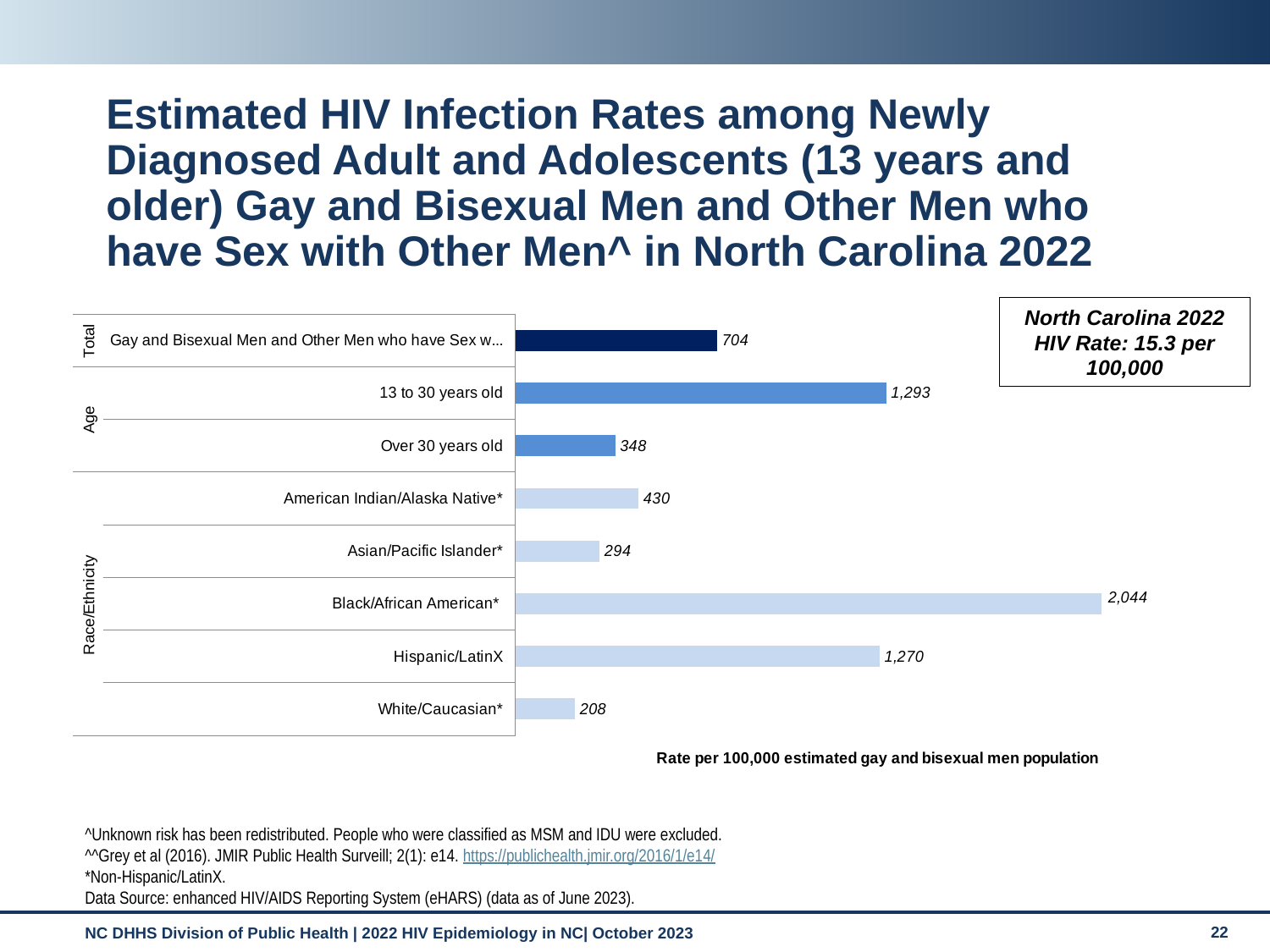
Which category on the chart has the lowest estimated HIV infection rate? White/Caucasian* What is the difference between the rates for 13 to 30 years old and Over 30 years old? 945 What is the estimated HIV infection rate for White/Caucasian* gay and bisexual men? 208 What kind of chart is shown on the slide? Bar chart Which has a higher rate, American Indian/Alaska Native* or Asian/Pacific Islander*? American Indian/Alaska Native* What is the difference between the rates for Black/African American* and Hispanic/LatinX? 774 What is the estimated HIV infection rate for the 13 to 30 years old group? 1,293 What is the estimated HIV infection rate for Black/African American* gay and bisexual men? 2,044 Which race/ethnicity category has the highest estimated HIV infection rate? Black/African American* What is the North Carolina 2022 HIV rate shown in the box on the slide? 15.3 per 100,000 How many categories are plotted on the chart? 8 What is the total estimated HIV infection rate for gay and bisexual men and other men who have sex with men? 704